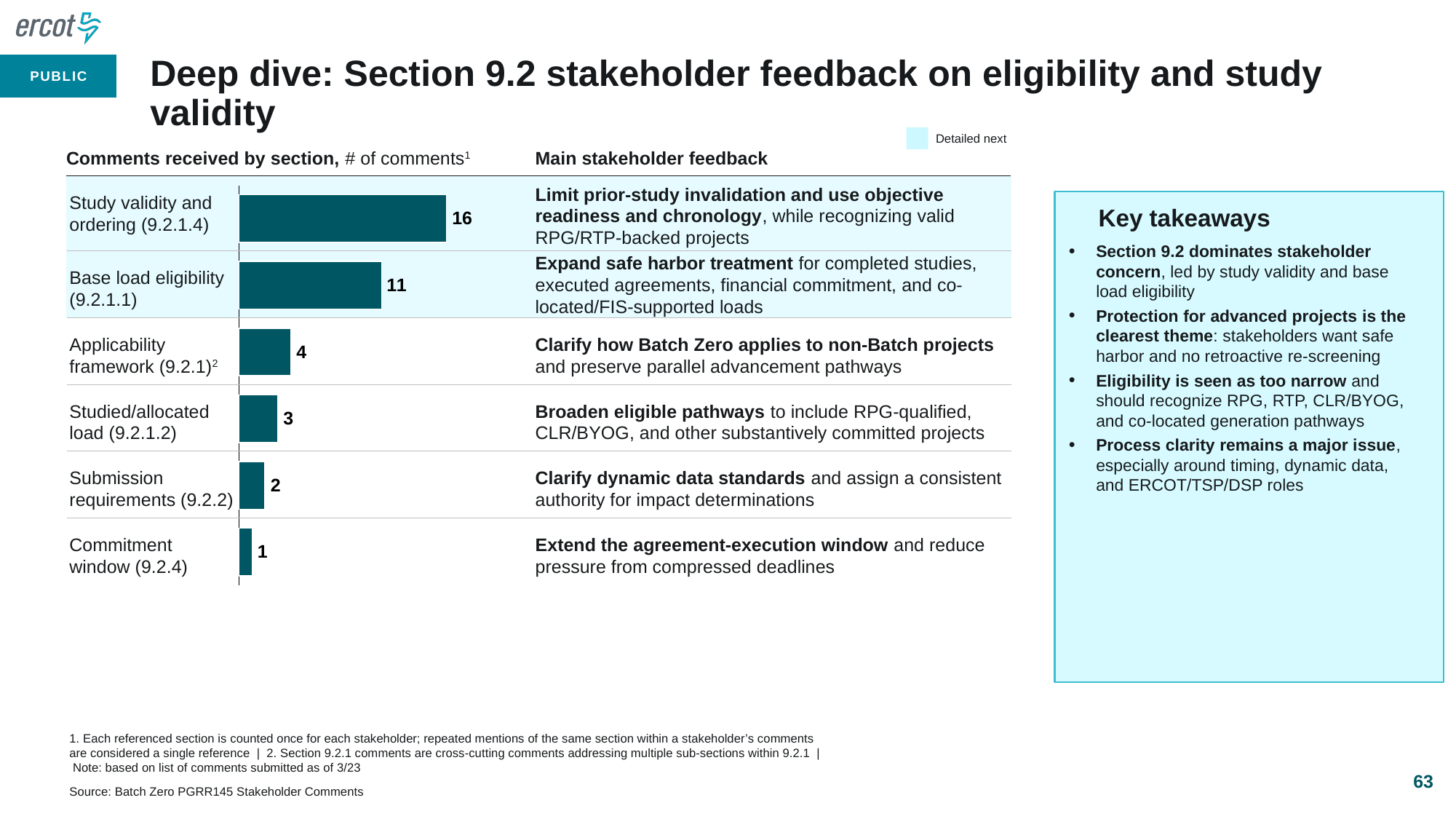
How many comments were received for Study validity and ordering (9.2.1.4)? 16 What is the total number of comments across Applicability framework (9.2.1), Studied/allocated load (9.2.1.2), and Commitment window (9.2.4)? 8 Which section received the most comments? Study validity and ordering (9.2.1.4) What does the light blue shading on the first two rows of the chart indicate, according to the legend? Detailed next What kind of chart is used to show comments received by section? Bar chart How many sections are shown in the chart? 6 Which received more comments: Applicability framework (9.2.1) or Studied/allocated load (9.2.1.2)? Applicability framework (9.2.1) What is the title of the chart on the left of the slide? Comments received by section, # of comments How many comments were received for Base load eligibility (9.2.1.1)? 11 Which section received the fewest comments? Commitment window (9.2.4) How many comments were received for Submission requirements (9.2.2)? 2 What is the difference in number of comments between Study validity and ordering (9.2.1.4) and Base load eligibility (9.2.1.1)? 5